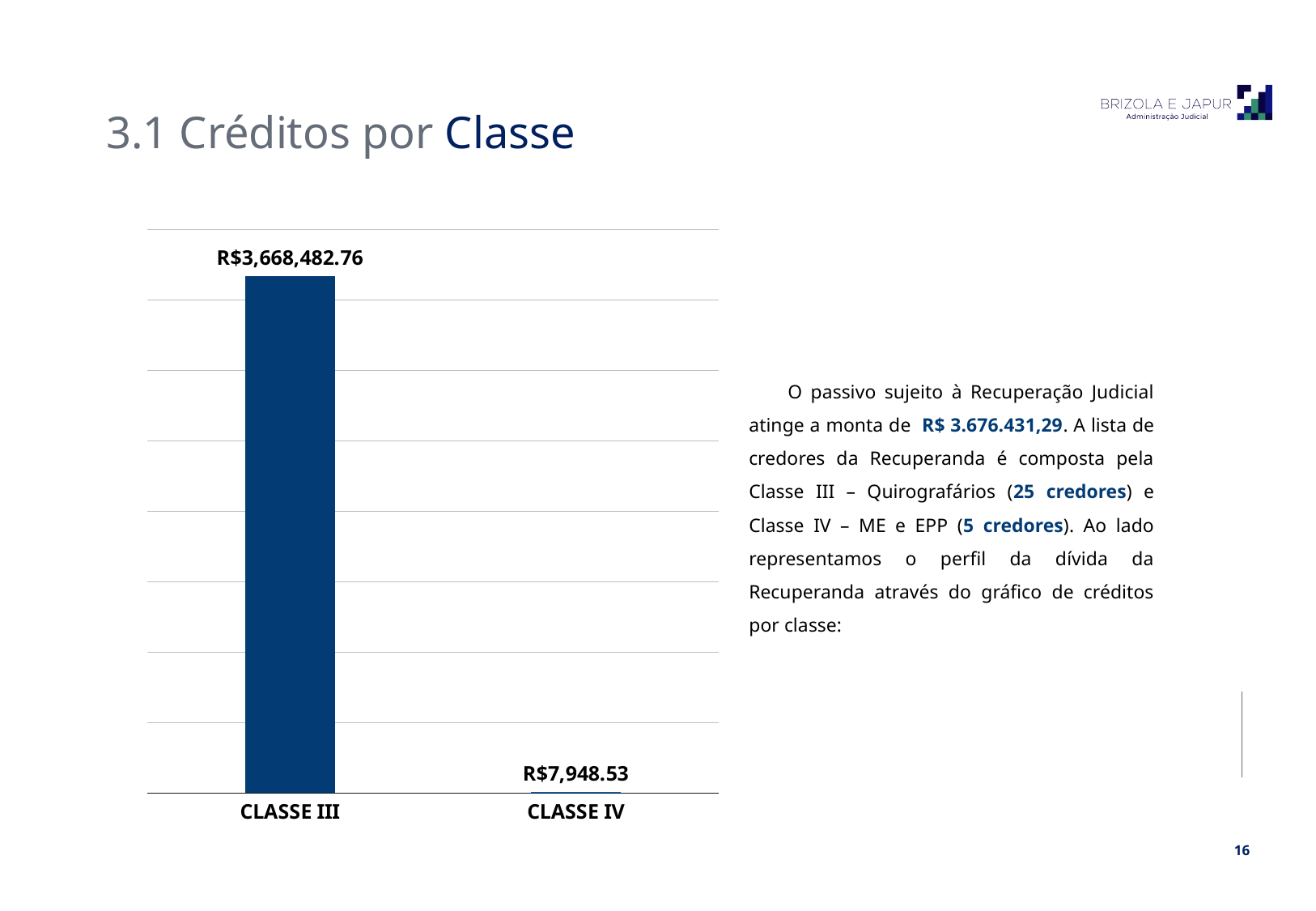
Do the values rise or fall from CLASSE III to CLASSE IV? Fall Which class has the highest value in the chart? CLASSE III What kind of chart is shown on the slide? Bar chart What is the title of the slide containing the chart? 3.1 Créditos por Classe What is the sum of the values for CLASSE III and CLASSE IV? R$3,676,431.29 What is the difference between the values for CLASSE III and CLASSE IV? R$3,660,534.23 What is the value shown for CLASSE III? R$3,668,482.76 How many categories are shown in the chart? 2 Which is larger, the value for CLASSE III or the value for CLASSE IV? CLASSE III What colour are the bars in the chart? Dark blue What is the value shown for CLASSE IV? R$7,948.53 Which class has the lowest value in the chart? CLASSE IV